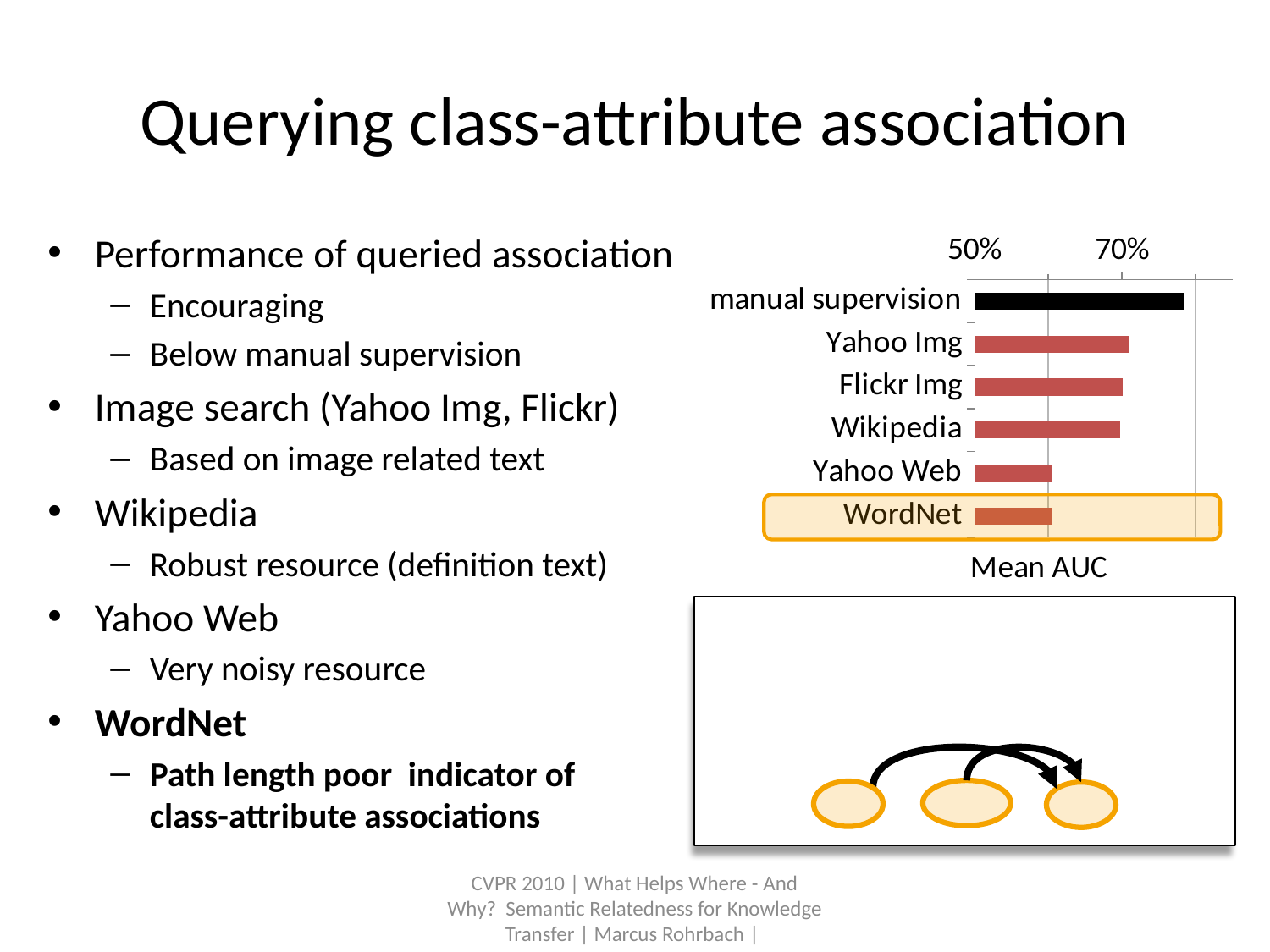
Is the Mean AUC for WordNet greater or less than 70%? less Which has a higher Mean AUC, manual supervision or Yahoo Web? manual supervision Which has a higher Mean AUC, Wikipedia or Yahoo Web? Wikipedia Which category has the highest Mean AUC in the bar chart? manual supervision Which has a higher Mean AUC, Yahoo Img or WordNet? Yahoo Img Which category in the bar chart is highlighted with an orange box? WordNet How many categories are plotted in the bar chart? 6 What is the label of the horizontal axis of the bar chart? Mean AUC What kind of chart is shown on the slide? bar chart Is the Mean AUC for Yahoo Web greater or less than 70%? less Is the Mean AUC for Yahoo Img greater or less than 50%? greater